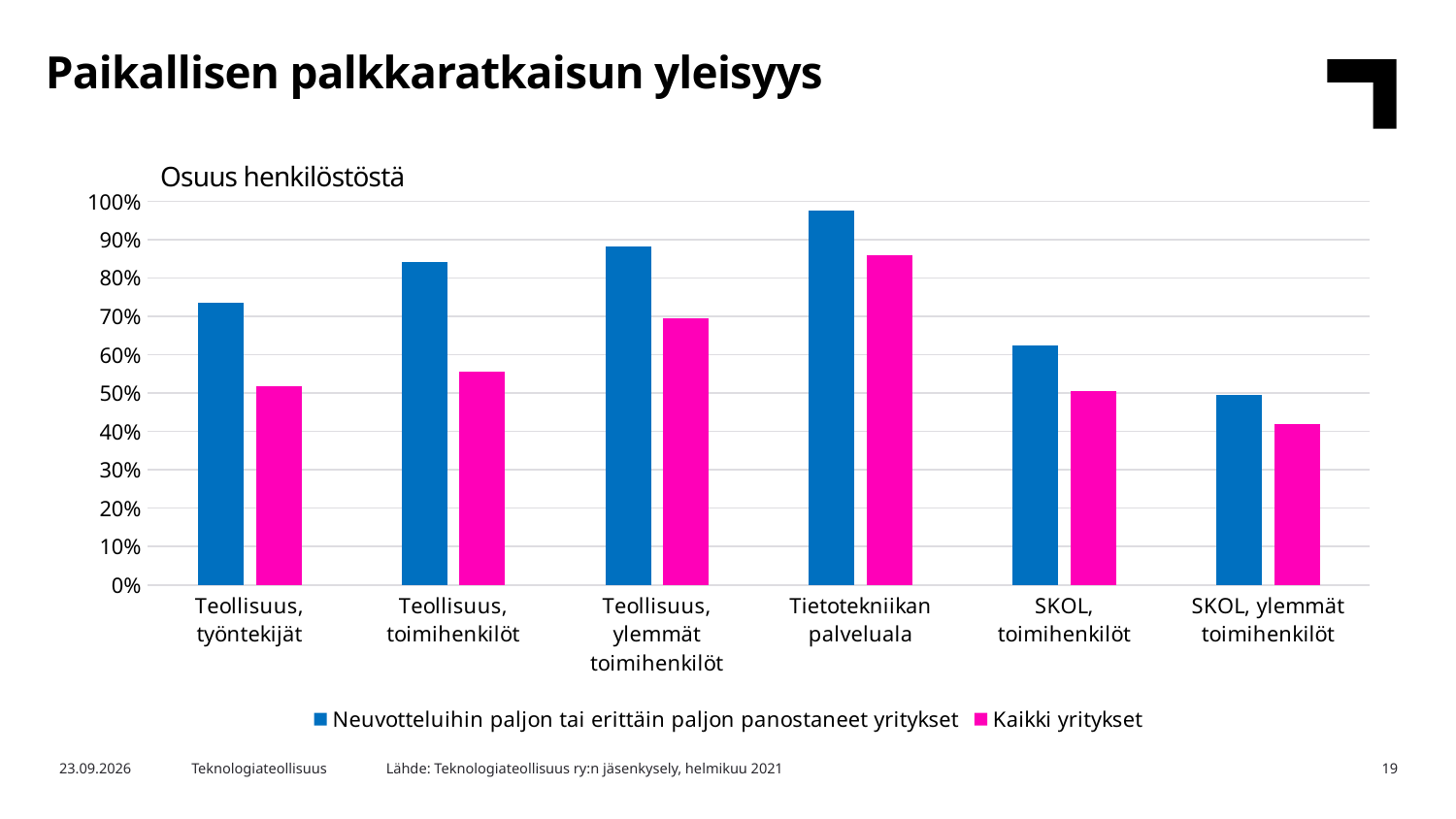
How many series does the legend list? 2 Which category has the highest value for the series 'Kaikki yritykset'? Tietotekniikan palveluala What kind of chart is shown on the slide? bar chart What is the title of the chart on the slide? Osuus henkilöstöstä Is the value for 'Tietotekniikan palveluala' in the series 'Neuvotteluihin paljon tai erittäin paljon panostaneet yritykset' greater or less than 90%? greater Is the value for 'Teollisuus, työntekijät' in the series 'Kaikki yritykset' greater or less than 60%? less Is the value for 'Teollisuus, toimihenkilöt' in the series 'Neuvotteluihin paljon tai erittäin paljon panostaneet yritykset' greater or less than 80%? greater Which category has the highest value for the series 'Neuvotteluihin paljon tai erittäin paljon panostaneet yritykset'? Tietotekniikan palveluala Which category has the lowest value for the series 'Kaikki yritykset'? SKOL, ylemmät toimihenkilöt How many categories are shown on the x axis of the chart? 6 Which is larger for the series 'Kaikki yritykset': 'Teollisuus, toimihenkilöt' or 'Tietotekniikan palveluala'? Tietotekniikan palveluala For 'Teollisuus, ylemmät toimihenkilöt', which series has the larger value: 'Neuvotteluihin paljon tai erittäin paljon panostaneet yritykset' or 'Kaikki yritykset'? Neuvotteluihin paljon tai erittäin paljon panostaneet yritykset